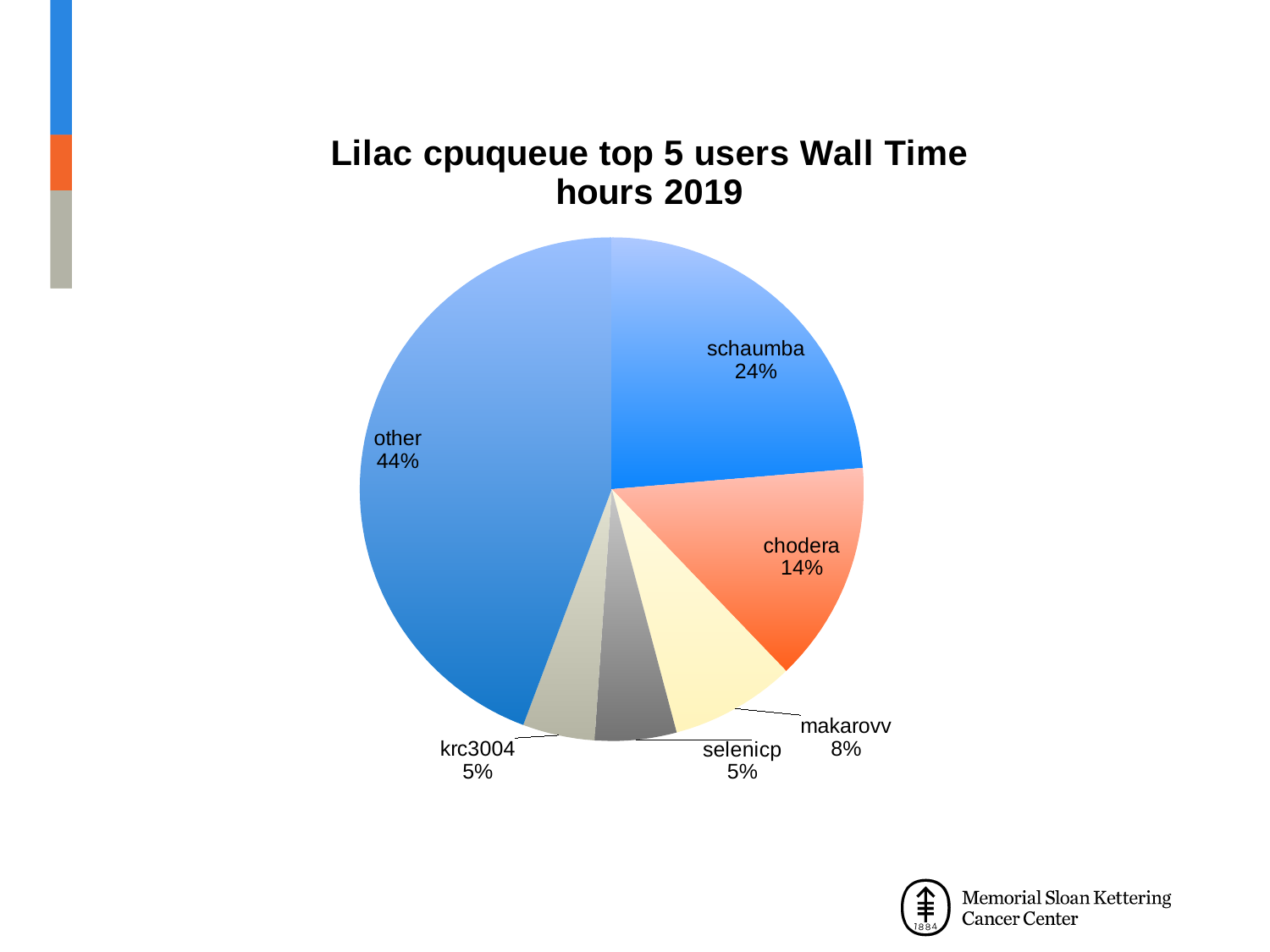
How many slices does the pie chart have? 6 Which is larger, the share for chodera or the share for makarovv? chodera What is the difference in percentage points between schaumba and chodera? 10 Which slice of the pie is the largest? other What share of the pie does makarovv have? 8% What is the title of the chart? Lilac cpuqueue top 5 users Wall Time hours 2019 What share of the pie does chodera have? 14% What share of the pie does the 'other' slice have? 44% Which named user among the top 5 has the largest share? schaumba What is the combined share of krc3004 and selenicp? 10% What kind of chart is shown on the slide? pie chart